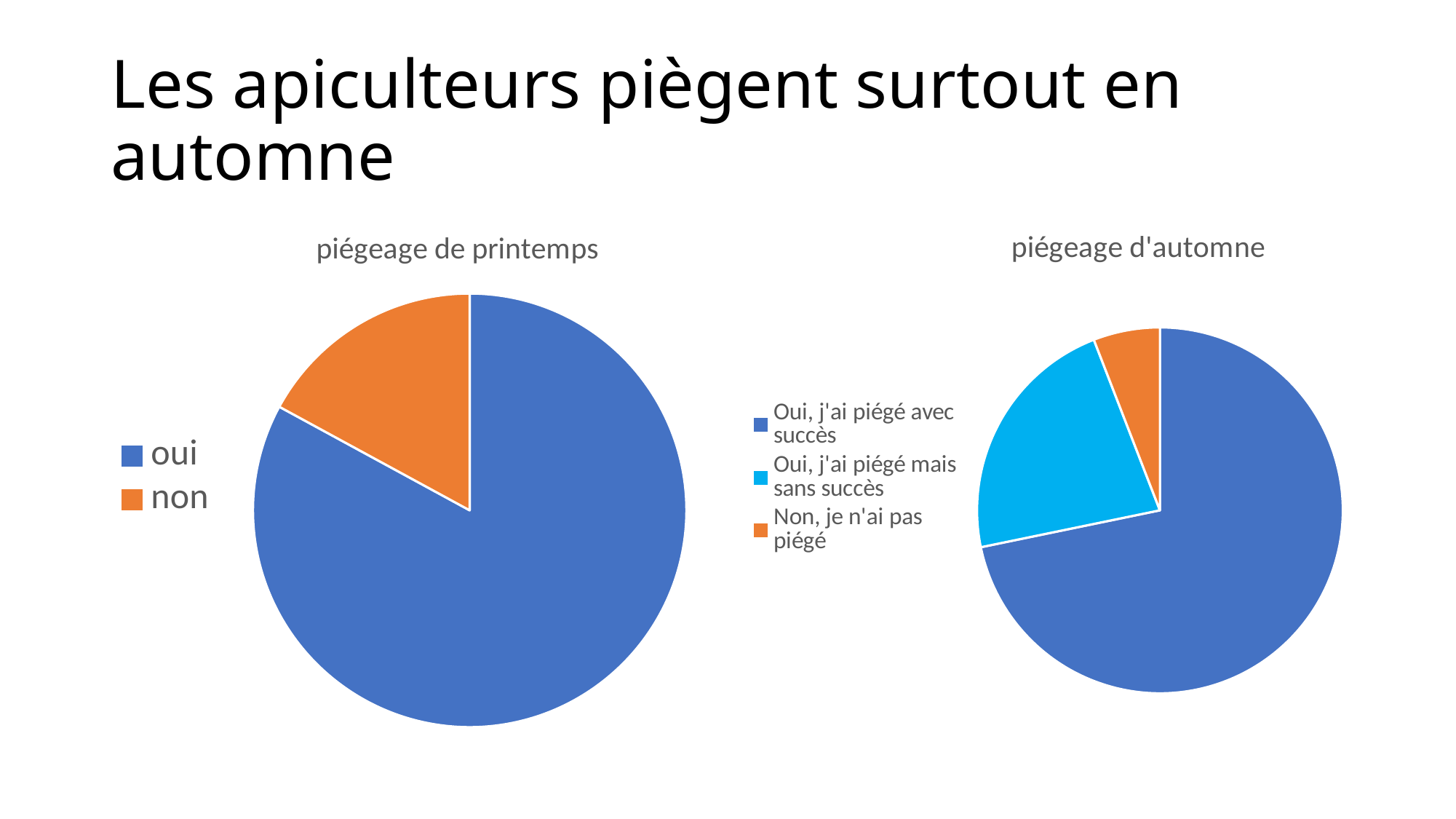
In the "piégeage de printemps" chart, which category has the largest slice? oui What kind of chart is the "piégeage de printemps" chart? pie chart In the "piégeage de printemps" chart, which slice is larger: "oui" or "non"? oui What kind of chart is the "piégeage d'automne" chart? pie chart In the "piégeage d'automne" chart, which category has the largest slice? Oui, j'ai piégé avec succès In the "piégeage d'automne" chart, which category has the smallest slice? Non, je n'ai pas piégé In the "piégeage d'automne" chart, what colour is the "Non, je n'ai pas piégé" slice? orange In the "piégeage de printemps" chart, which category has the smallest slice? non In the "piégeage d'automne" chart, how many slices does the pie have? 3 In the "piégeage d'automne" chart, which slice is larger: "Oui, j'ai piégé mais sans succès" or "Non, je n'ai pas piégé"? Oui, j'ai piégé mais sans succès How many entries does the legend of the "piégeage d'automne" chart list? 3 In the "piégeage de printemps" chart, how many slices does the pie have? 2